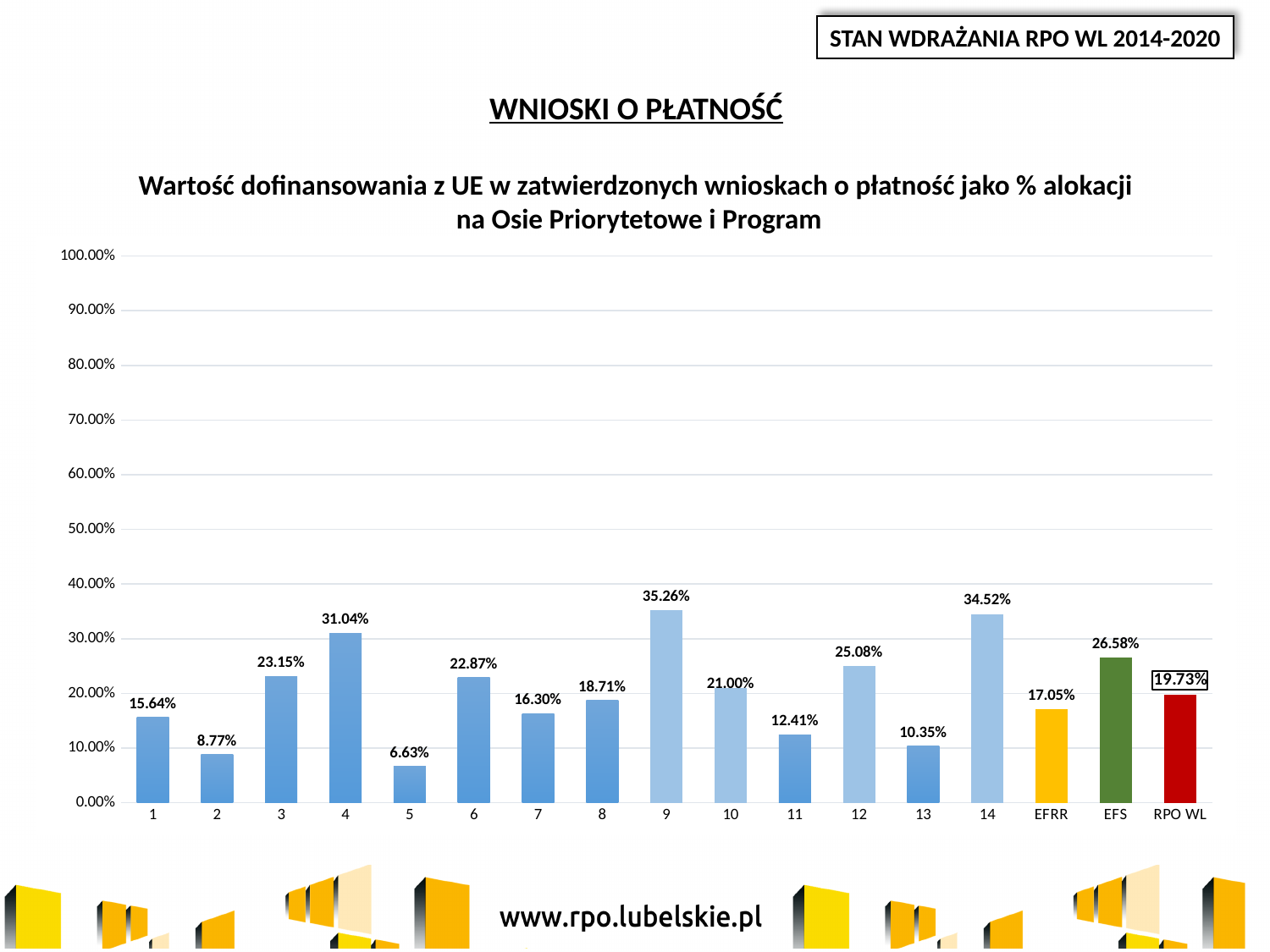
What is the value for EFRR? 17.05% Is the value for category 12 greater or less than 20.00%? greater What kind of chart is shown on the slide? bar chart How many categories are shown on the x axis? 17 Which category has the lowest value? 5 What colour is the bar for RPO WL? red Which category has the highest value? 9 What is the value for RPO WL? 19.73% What is the value for category 9? 35.26% What is the value for category 5? 6.63% Which is larger, the value for category 4 or the value for category 14? 14 What is the difference between the values for EFS and EFRR? 9.53%